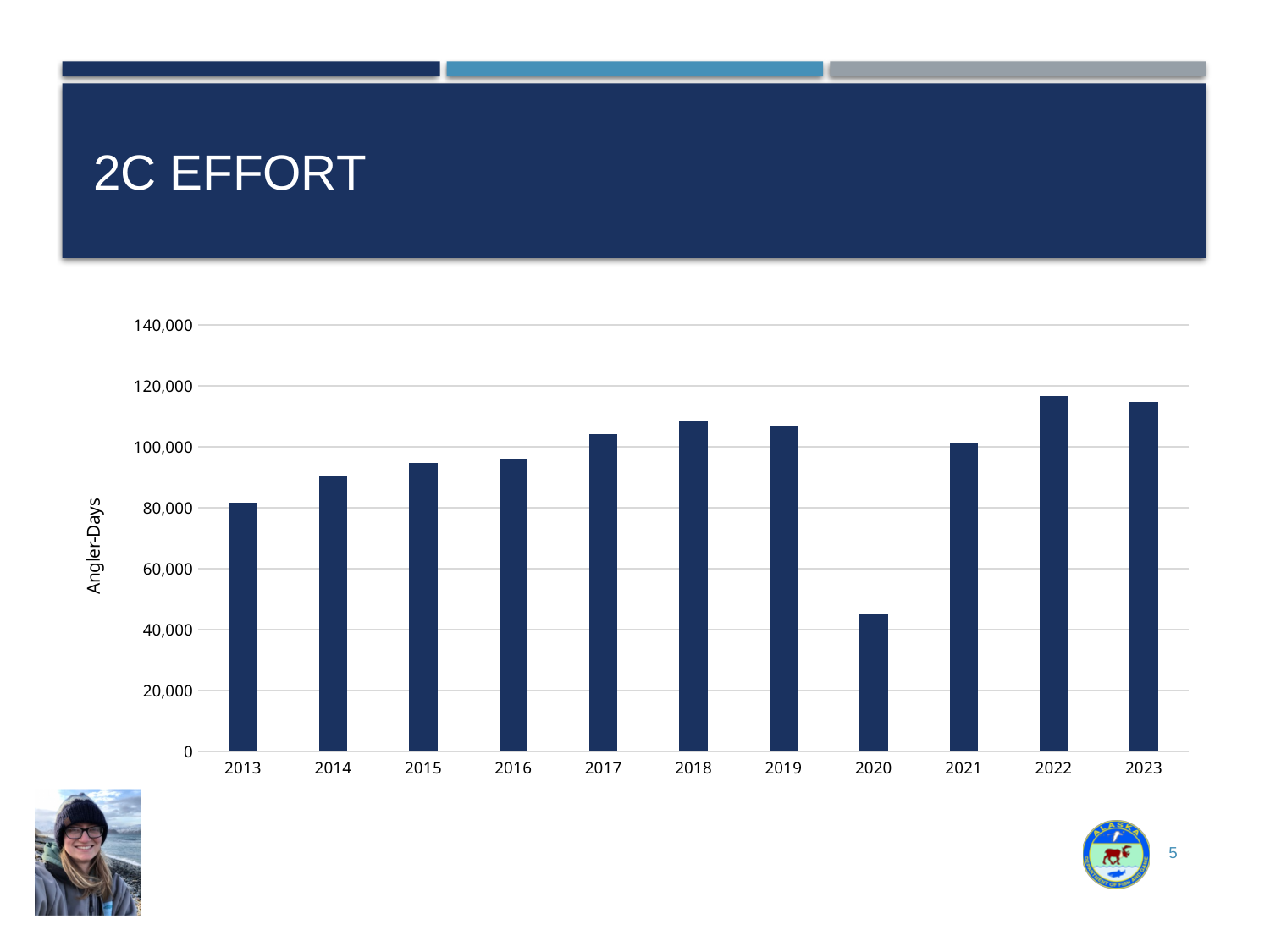
What is the title of the slide containing the chart? 2C EFFORT How many years are plotted on the x axis of the chart? 11 Is the value for 2014 greater or less than 100,000 angler-days? less Is the value for 2013 greater or less than 100,000 angler-days? less Which year has the lowest number of angler-days? 2020 Do the angler-days values rise or fall from 2013 to 2018? rise What kind of chart is shown on the slide? bar chart Is the value for 2022 greater or less than 100,000 angler-days? greater Which year has more angler-days, 2020 or 2021? 2021 What is the label on the y axis of the chart? Angler-Days Which year has more angler-days, 2013 or 2018? 2018